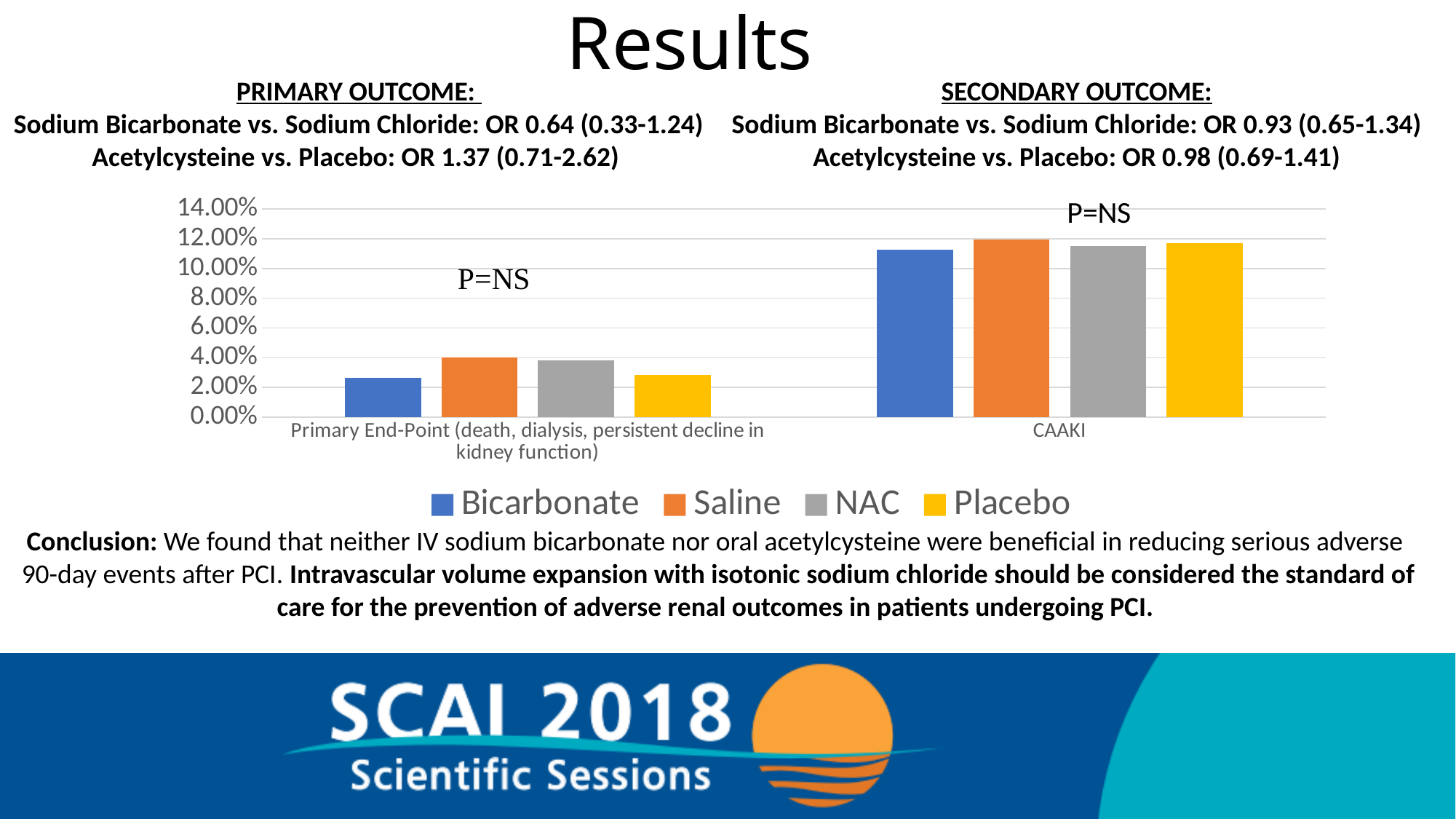
How many categories are shown on the x axis of the chart? 2 Is the value for Bicarbonate in the Primary End-Point category greater or less than 4.00%? less In the Primary End-Point category, which is larger: Saline or Bicarbonate? Saline Which colour represents Placebo in the chart legend? yellow Which category has the higher Bicarbonate value: Primary End-Point or CAAKI? CAAKI How many series does the chart legend list? 4 Is the value for Placebo in the Primary End-Point category greater or less than 4.00%? less What kind of chart is shown on the slide? bar chart Is the value for Saline in the CAAKI category greater or less than 14.00%? less In the Primary End-Point category, which is larger: NAC or Placebo? NAC